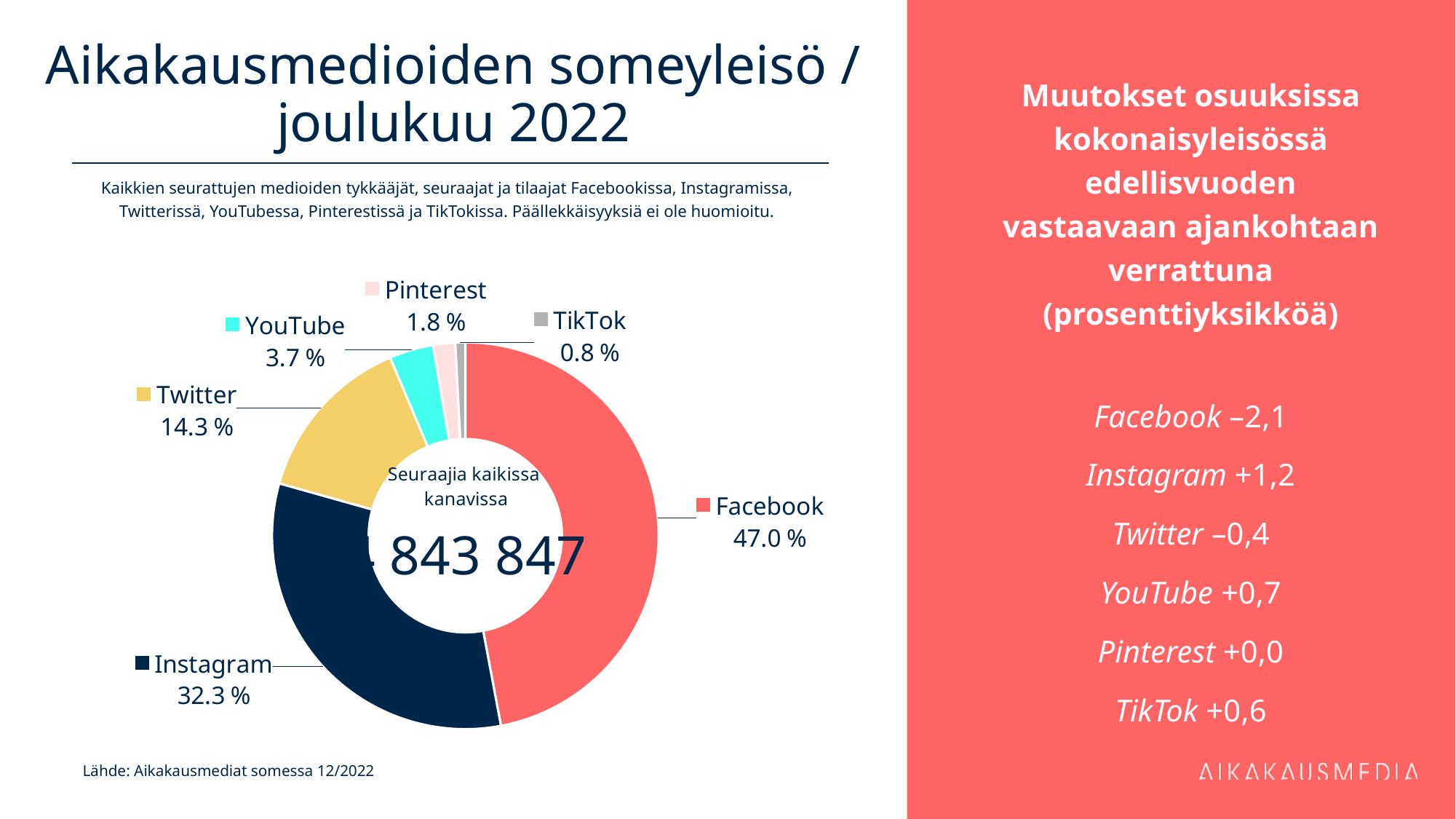
What share of the social media audience does Instagram have? 32.3 % What share of the social media audience does Facebook have? 47.0 % Which channel has the smallest share in the chart? TikTok What colour is the Instagram slice in the chart? Dark navy blue What type of chart is shown on the slide? Pie chart (donut) What is the difference in percentage points between Facebook's and Instagram's shares? 14.7 percentage points Which has a larger share, Twitter or YouTube? Twitter What share of the social media audience does Twitter have? 14.3 % What share of the social media audience does YouTube have? 3.7 % What share of the social media audience does TikTok have? 0.8 % Which channel has the largest share in the chart? Facebook How many channels (slices) are shown in the chart? 6